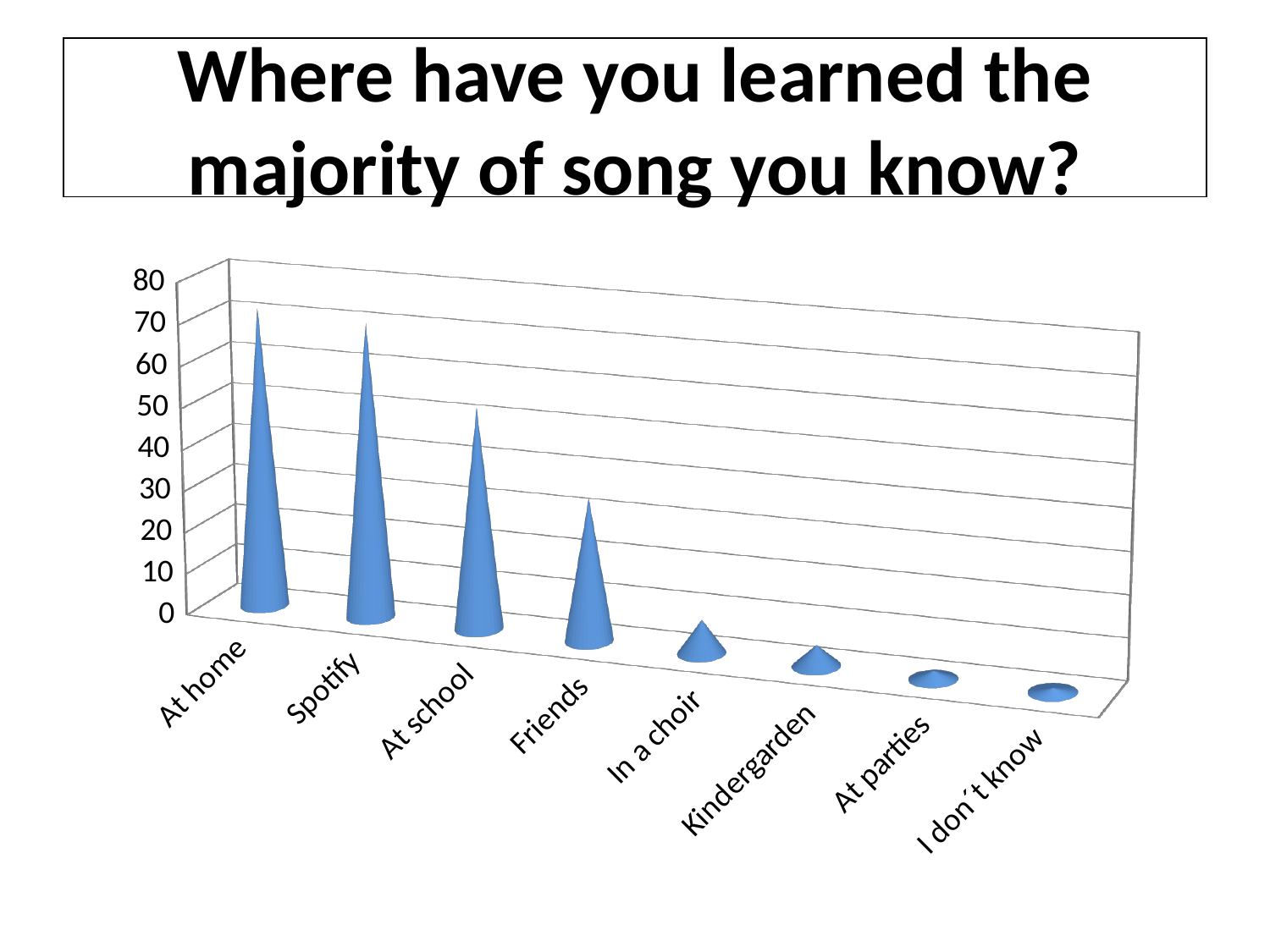
Is the value for In a choir greater or less than 20? less Is the value for Kindergarden greater or less than 10? less Is the value for At home greater or less than 60? greater What is the title of the slide above the chart? Where have you learned the majority of song you know? Which category has the lowest value in the chart? I don´t know Do the values rise or fall moving from left to right along the x axis? fall How many categories are shown on the x axis of the chart? 8 What kind of chart is shown on the slide? bar chart Which is larger, the value for Spotify or the value for At school? Spotify